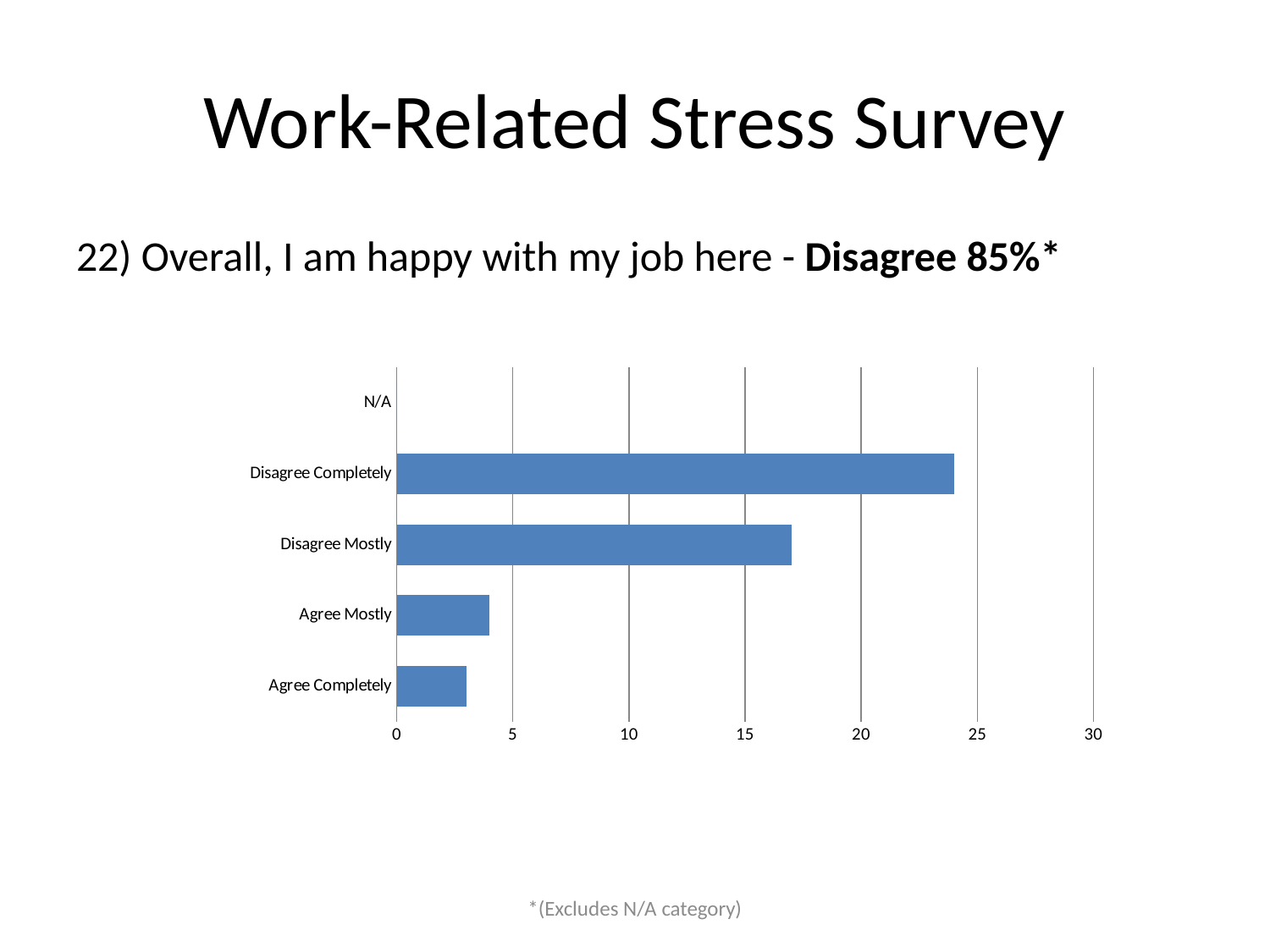
According to the footnote below the chart, which category is excluded from the 85% figure? N/A category Which category has the lowest value in the chart? N/A Which category has the longest bar? Disagree Completely What is the highest value shown on the horizontal axis of the chart? 30 Which is larger, the value for Disagree Mostly or the value for Agree Mostly? Disagree Mostly What kind of chart is shown on the slide? bar chart How many categories are listed on the vertical axis of the chart? 5 Is the value for Disagree Mostly greater or less than 20? less Is the value for Disagree Mostly greater or less than 15? greater Is the value for Disagree Completely greater or less than 20? greater